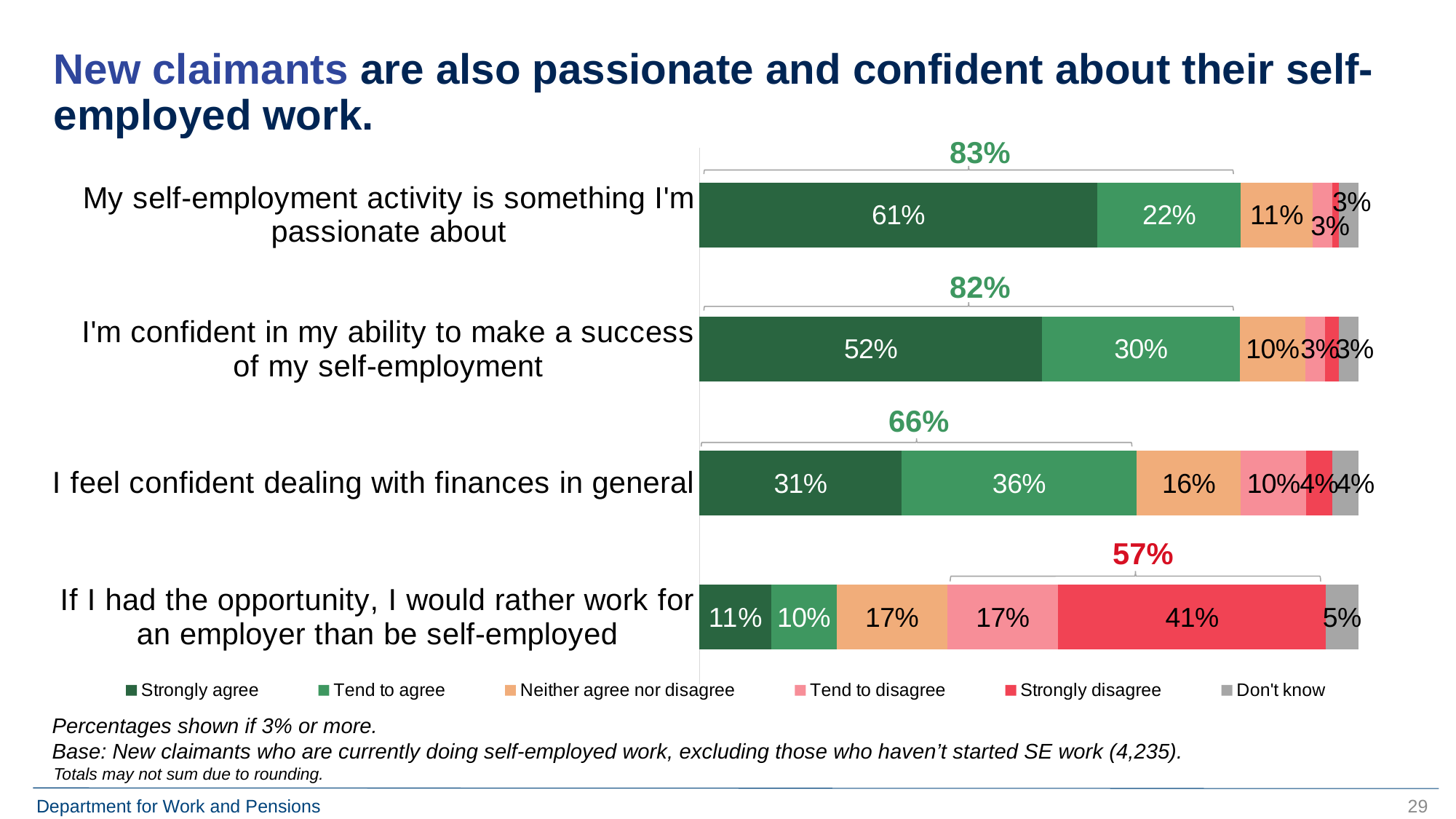
Which statement has a larger 'Tend to agree' share: 'I'm confident in my ability to make a success of my self-employment' or 'My self-employment activity is something I'm passionate about'? I'm confident in my ability to make a success of my self-employment What percentage of new claimants strongly agree that their self-employment activity is something they are passionate about? 61% What percentage tend to agree with the statement 'I feel confident dealing with finances in general'? 36% What percentage strongly disagree with the statement 'If I had the opportunity, I would rather work for an employer than be self-employed'? 41% How many statements are shown in the chart? 4 What combined percentage is shown in red above the bar for 'If I had the opportunity, I would rather work for an employer than be self-employed'? 57% What combined agreement percentage is shown above the bar for 'I'm confident in my ability to make a success of my self-employment'? 82% Which statement has the lowest 'Strongly agree' percentage? If I had the opportunity, I would rather work for an employer than be self-employed What type of chart is shown on the slide? Stacked bar chart How many percentage points higher is 'Strongly agree' for the passionate statement (61%) than for the confident-in-ability statement (52%)? 9 percentage points How many response categories does the legend list? 6 Which statement has the highest 'Strongly agree' percentage? My self-employment activity is something I'm passionate about